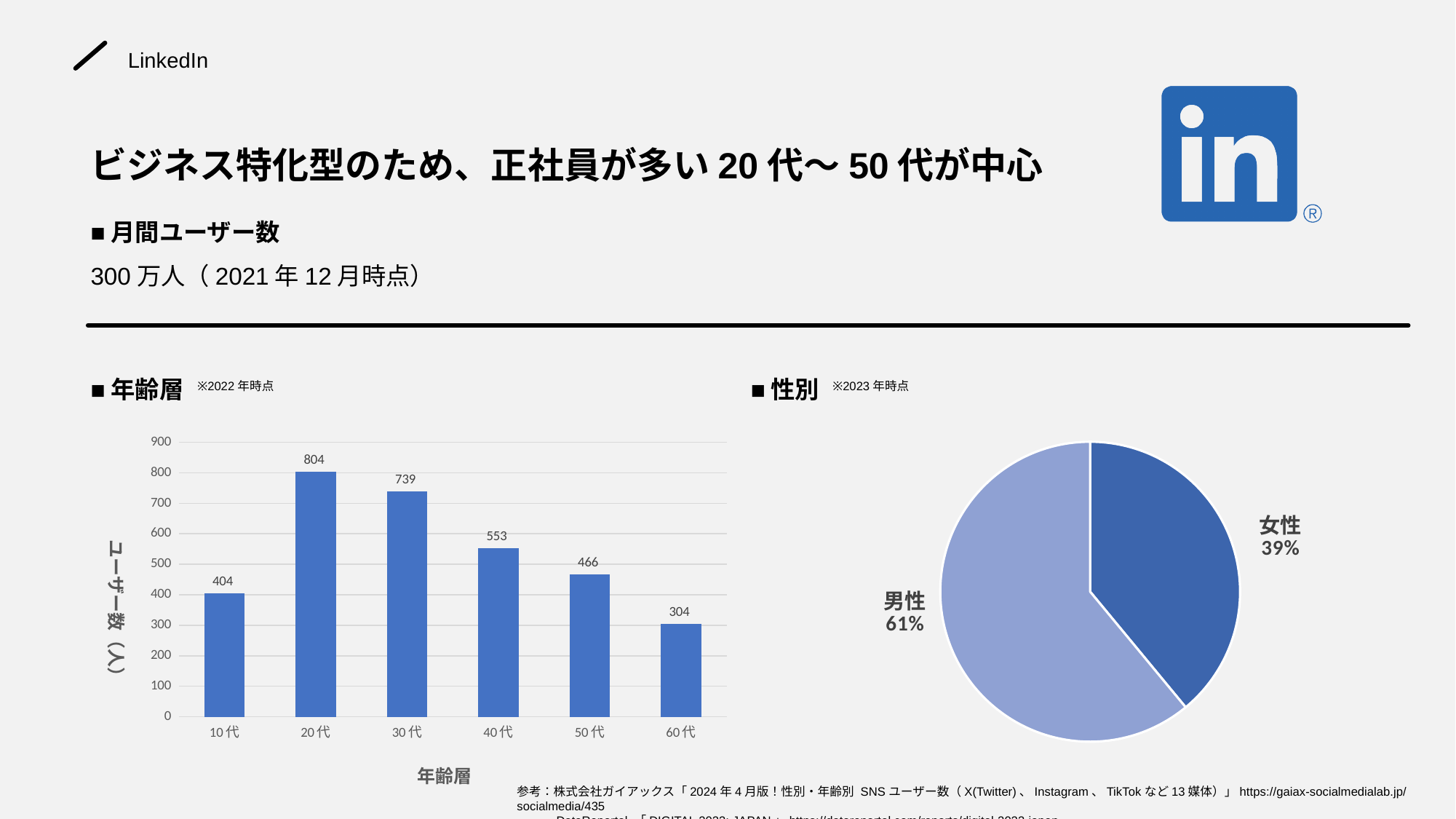
In the 年齢層 bar chart, is the value for 40代 greater or less than 500? greater In the 年齢層 bar chart, what is the difference between the values for 20代 and 30代? 65 What kind of chart is the 性別 chart? pie chart How many age groups are shown in the 年齢層 bar chart? 6 In the 年齢層 bar chart, do the values rise or fall from 20代 to 60代? fall What kind of chart is the 年齢層 chart? bar chart In the 年齢層 bar chart, what is the value for 60代? 304 In the 性別 pie chart, what share is 男性? 61% In the 年齢層 bar chart, which age group has the lowest number of users? 60代 In the 年齢層 bar chart, which age group has the highest number of users? 20代 In the 年齢層 bar chart, what is the value for 20代? 804 In the 年齢層 bar chart, which is larger, the value for 10代 or the value for 50代? 50代